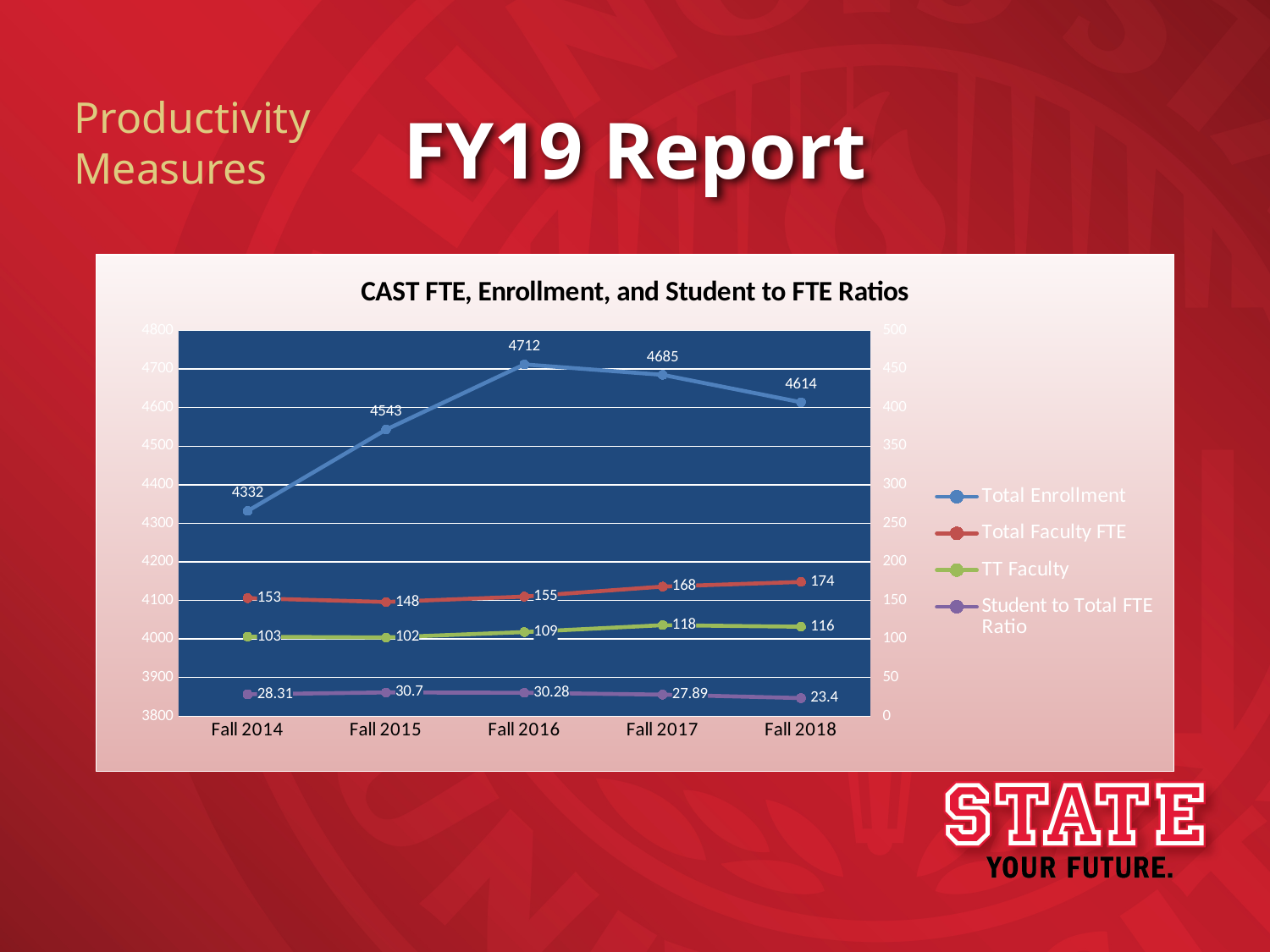
How many series does the legend list? 4 How many terms are shown on the x axis? 5 What is the difference in Total Enrollment between Fall 2016 and Fall 2014? 380 What is the Total Faculty FTE value for Fall 2018? 174 In which term is the Student to Total FTE Ratio lowest? Fall 2018 Which is larger, TT Faculty in Fall 2017 or TT Faculty in Fall 2018? Fall 2017 What kind of chart is this? Line chart Does Total Faculty FTE rise or fall from Fall 2015 to Fall 2018? Rise In which term is Total Enrollment highest? Fall 2016 What is the TT Faculty value for Fall 2015? 102 What is the Student to Total FTE Ratio for Fall 2017? 27.89 What is the Total Enrollment value for Fall 2016? 4712